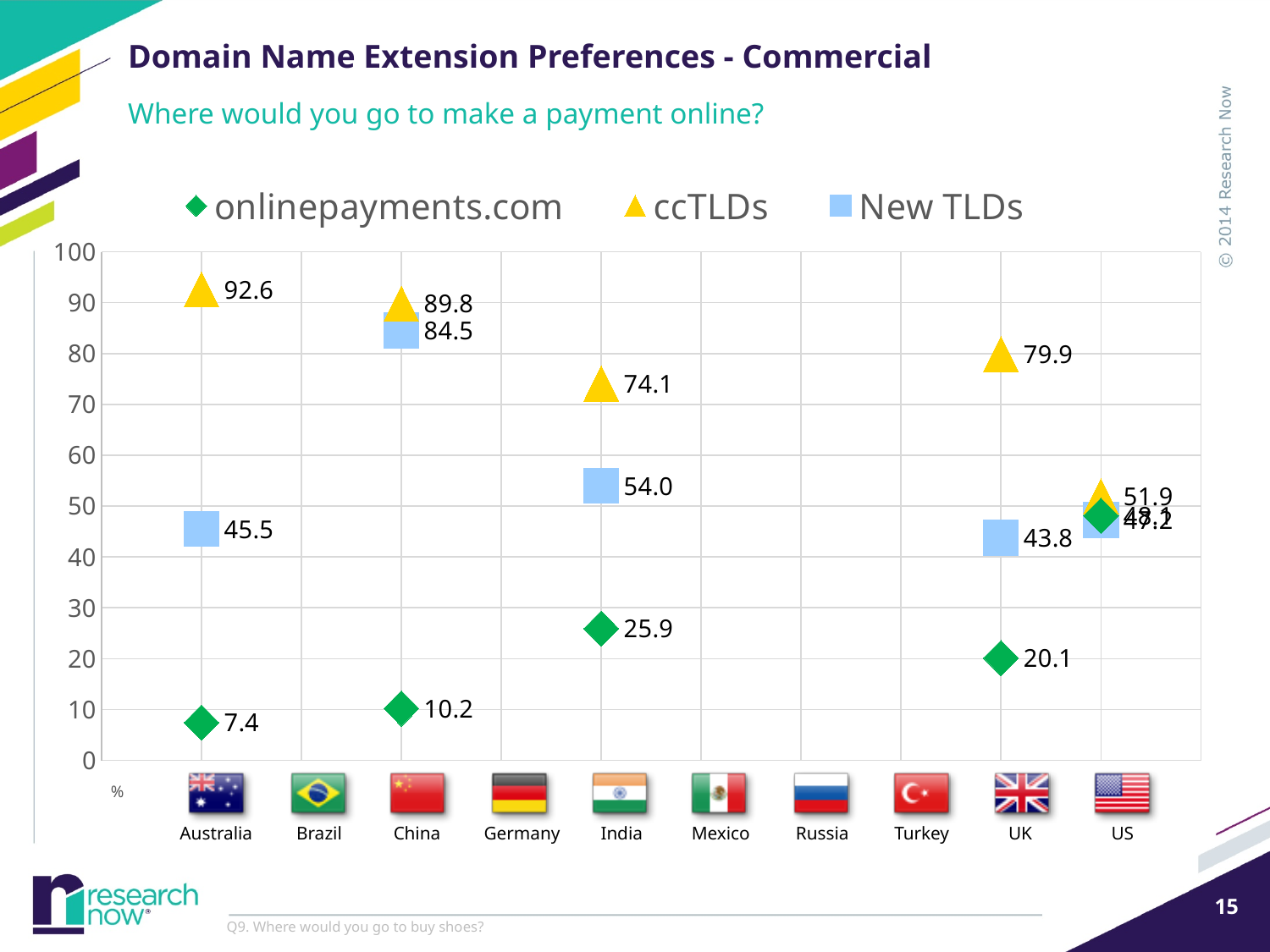
Which country has the highest ccTLDs value? Australia Which is larger, the New TLDs value for India or for the UK? India Is the New TLDs value for the UK greater or less than 50? less What is the difference between the ccTLDs and New TLDs values for China? 5.3 How many series does the legend list? 3 What is the onlinepayments.com value for India? 25.9 What is the New TLDs value for China? 84.5 Which country has the lowest onlinepayments.com value? Australia Which country has the highest New TLDs value? China What is the ccTLDs value for the UK? 79.9 What is the ccTLDs value for Australia? 92.6 How many countries are shown along the x axis? 10